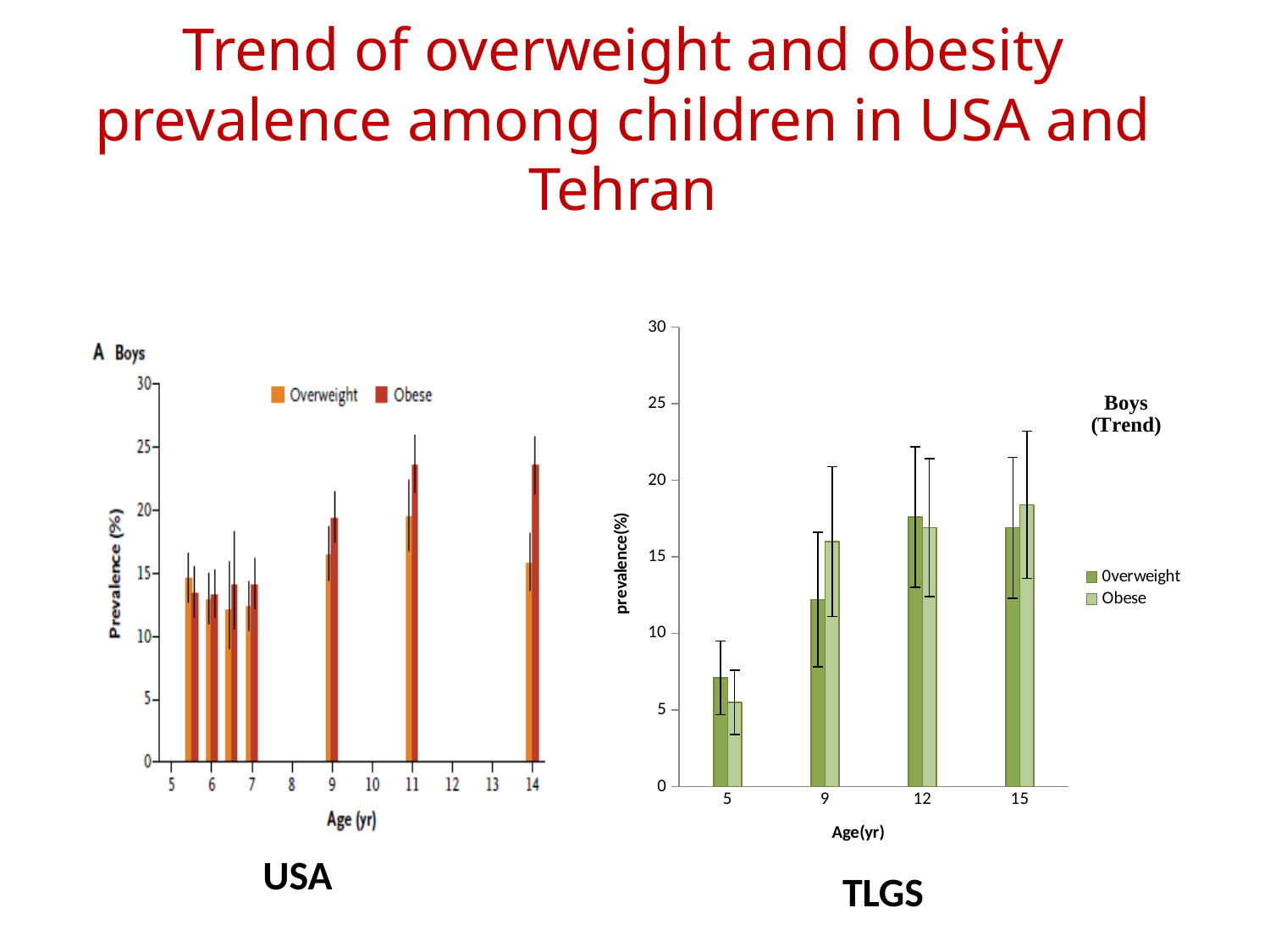
In the TLGS chart, does the Obese prevalence rise or fall from age 5 to age 15? rise What are the two legend entries in the USA chart? Overweight and Obese In the USA chart, is the Obese value at age 11 greater or less than 20? greater In the TLGS chart, at age 9, which is larger: Overweight or Obese? Obese In the TLGS chart, at which age is the Obese prevalence highest? 15 In the TLGS chart, is the Obese value at age 5 greater or less than 10? less In the USA chart, at age 9, which is larger: Overweight or Obese? Obese How many series does the legend of the TLGS chart list? 2 In the TLGS chart, at which age is the Overweight prevalence lowest? 5 In the TLGS chart, is the Overweight value at age 12 greater or less than 15? greater What kind of chart is the TLGS chart on the right of the slide? bar chart How many age groups are shown on the x axis of the TLGS chart? 4